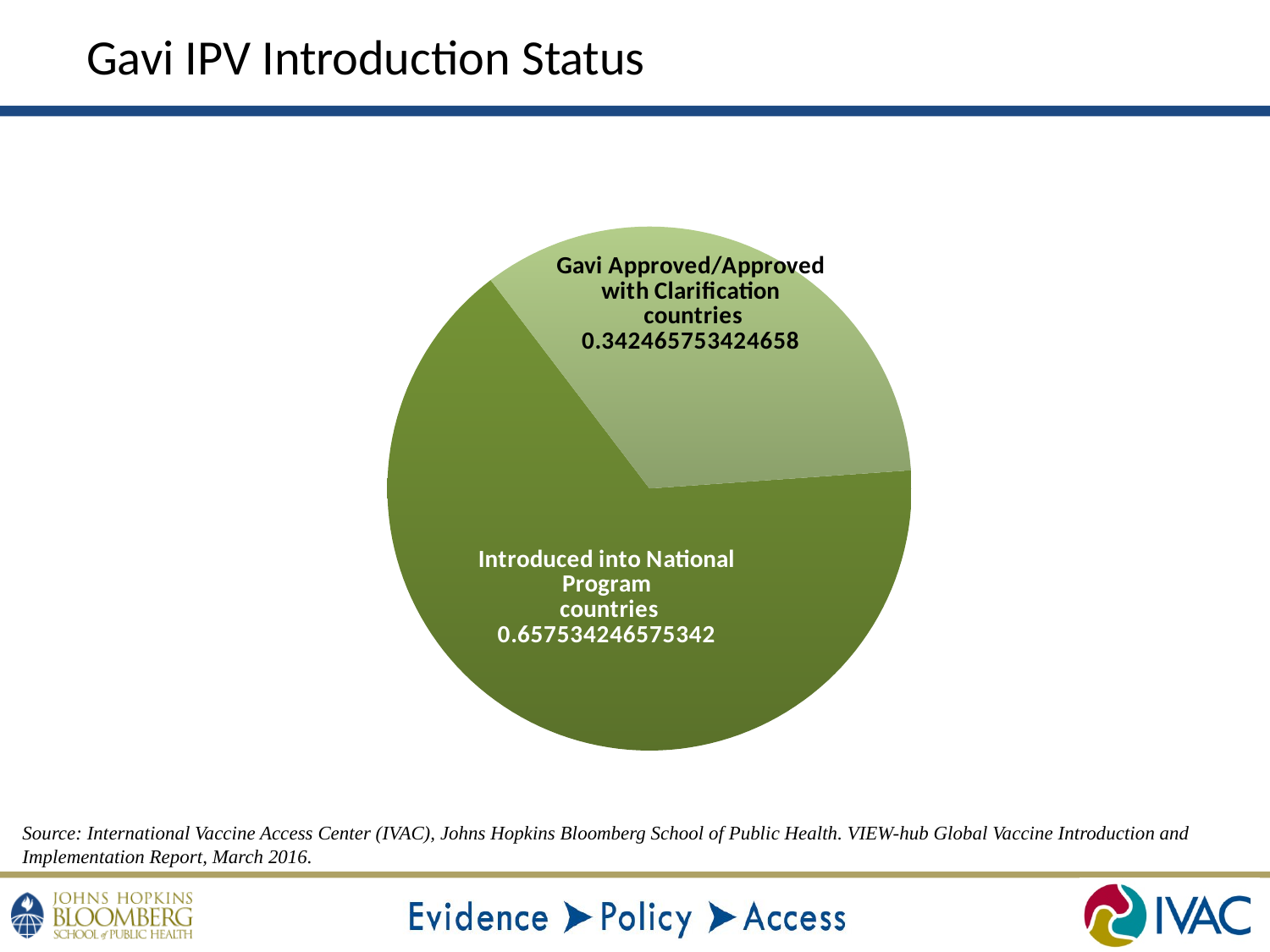
What is the value shown for Introduced into National Program countries? 0.657534246575342 What is the title of the chart on the slide? Gavi IPV Introduction Status Which is larger: the value for Introduced into National Program countries or the value for Gavi Approved/Approved with Clarification countries? Introduced into National Program countries Which category has the largest slice of the pie? Introduced into National Program countries How many slices does the pie chart have? 2 What share of the pie does the Introduced into National Program countries slice represent? 0.657534246575342 Which slice of the pie is shown in the darker green colour? Introduced into National Program countries What kind of chart is shown on the slide? pie chart What is the difference between the value for Introduced into National Program countries and the value for Gavi Approved/Approved with Clarification countries? 0.315068493150684 Which category has the smallest slice of the pie? Gavi Approved/Approved with Clarification countries What is the value shown for Gavi Approved/Approved with Clarification countries? 0.342465753424658